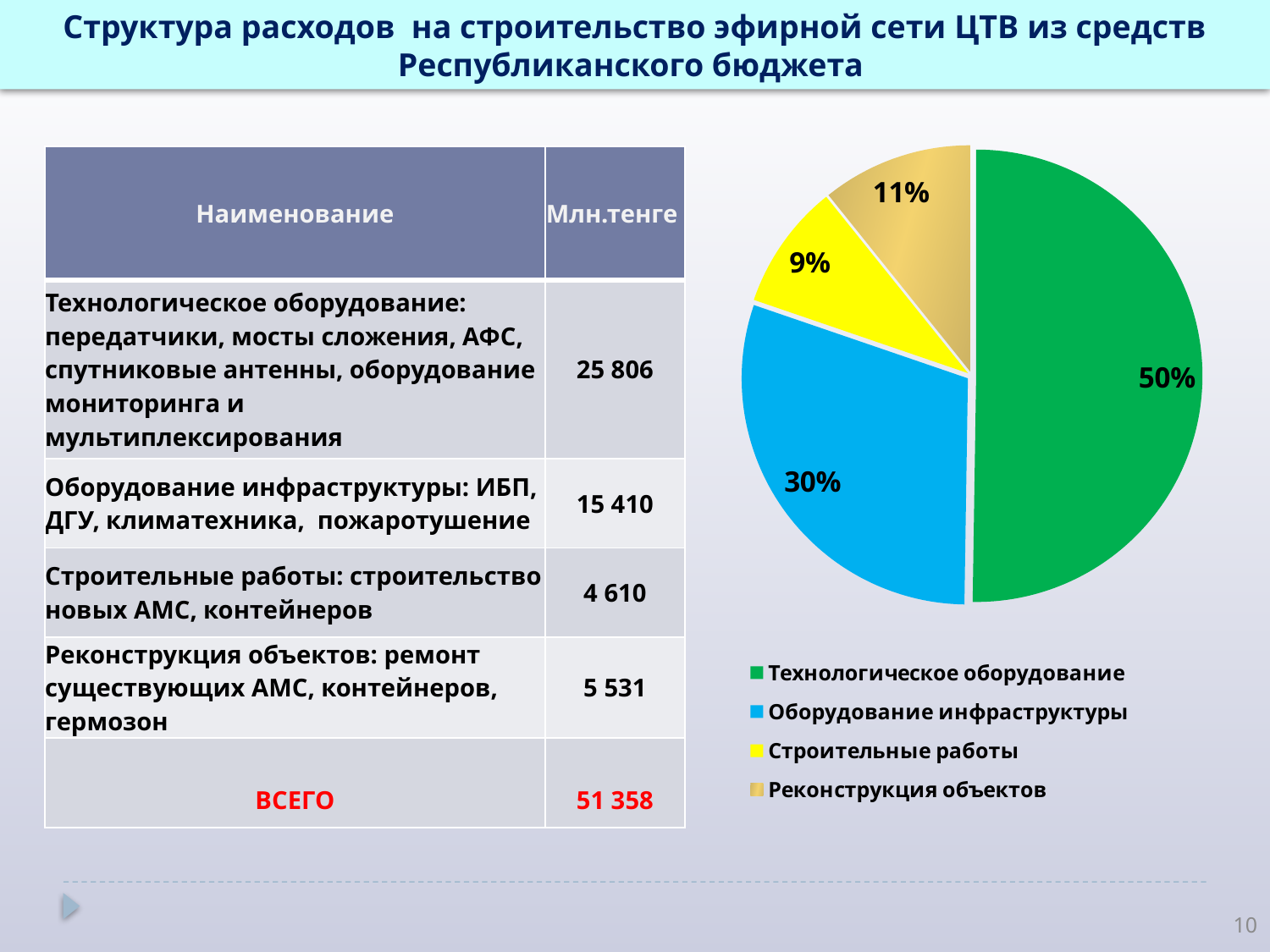
Which category has the largest slice of the pie? Технологическое оборудование What kind of chart is shown on the slide? pie chart What colour is the slice for Оборудование инфраструктуры? blue What is the difference in percentage points between the Технологическое оборудование slice and the Оборудование инфраструктуры slice? 20% How many slices does the pie chart have? 4 What share of the pie does Строительные работы have? 9% What share of the pie does Реконструкция объектов have? 11% What share of the pie does Технологическое оборудование have? 50% How many entries does the legend list? 4 Which is larger in the pie chart: Реконструкция объектов or Строительные работы? Реконструкция объектов Which category has the smallest slice of the pie? Строительные работы